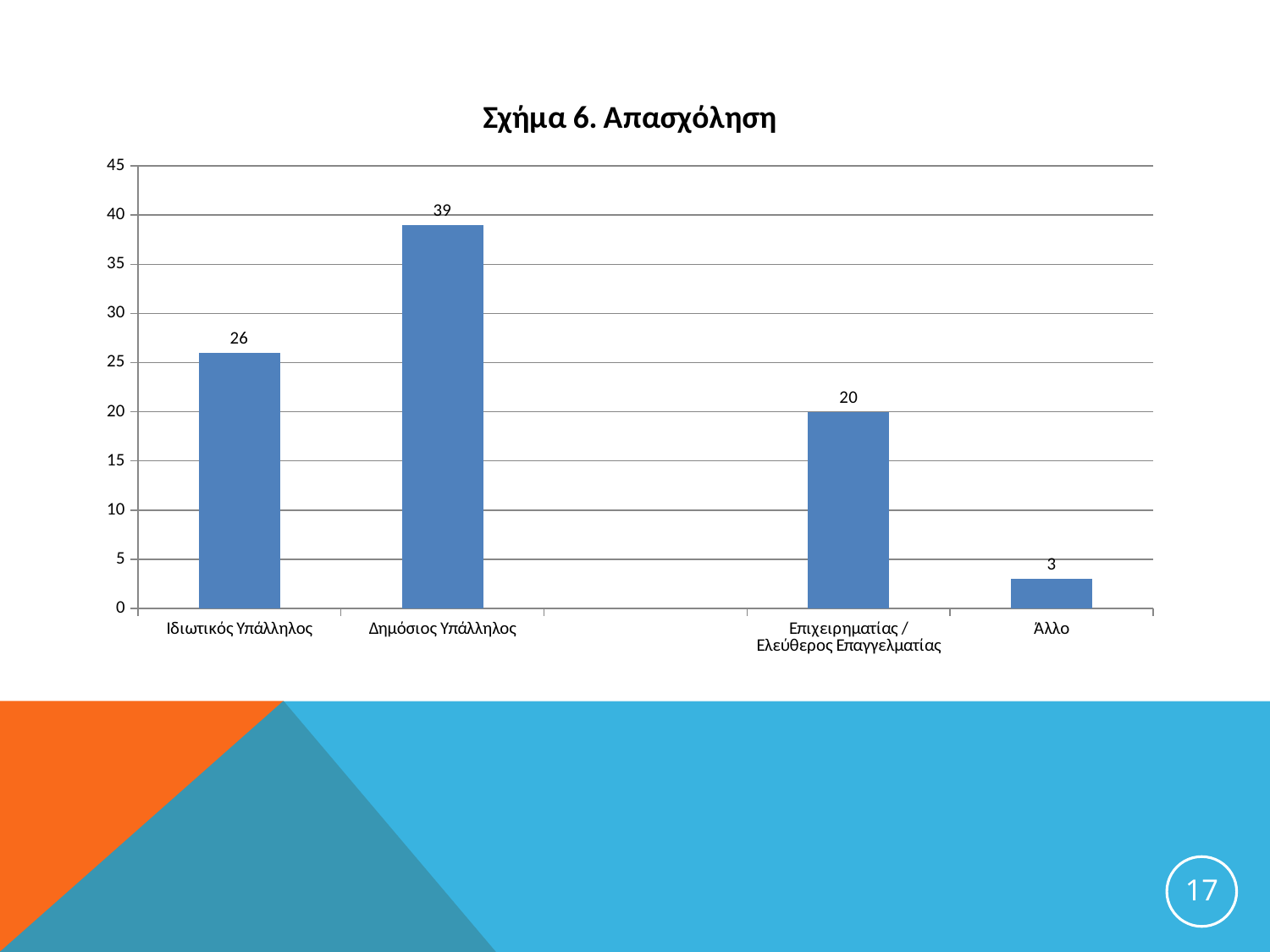
What is the value for Επιχειρηματίας / Ελεύθερος Επαγγελματίας? 20 How many categories are shown on the x axis? 4 What kind of chart is shown on the slide? bar chart Which category has the highest value? Δημόσιος Υπάλληλος What is the value for Ιδιωτικός Υπάλληλος? 26 Which category has the lowest value? Άλλο Which is larger, the value for Ιδιωτικός Υπάλληλος or the value for Επιχειρηματίας / Ελεύθερος Επαγγελματίας? Ιδιωτικός Υπάλληλος What is the difference between the values for Δημόσιος Υπάλληλος and Ιδιωτικός Υπάλληλος? 13 What is the title of the chart? Σχήμα 6. Απασχόληση What is the value for Άλλο? 3 What is the difference between the values for Επιχειρηματίας / Ελεύθερος Επαγγελματίας and Άλλο? 17 What is the value for Δημόσιος Υπάλληλος? 39